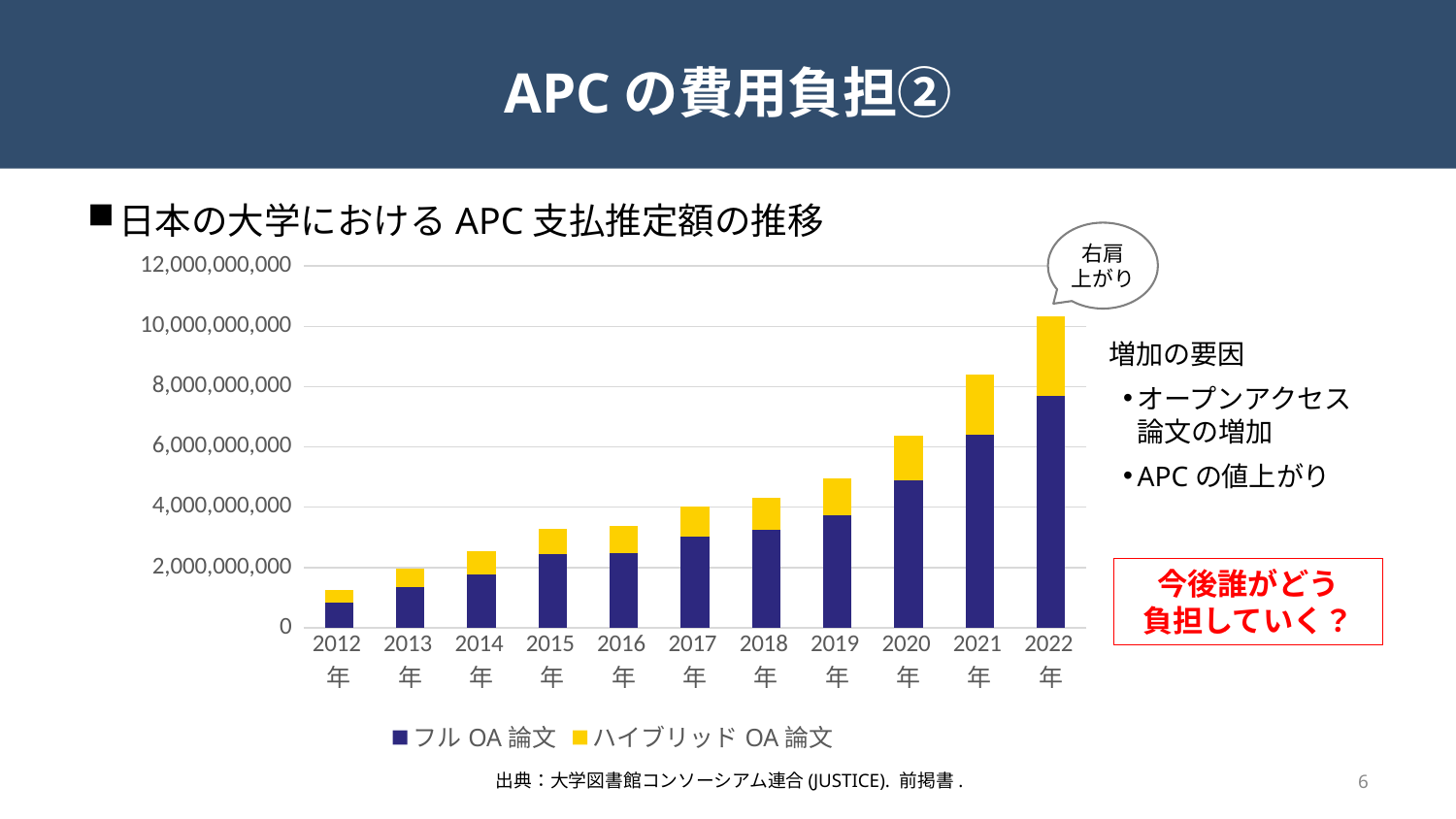
Which colour represents ハイブリッド OA 論文 in the chart? Yellow How many years are shown on the x axis of the chart? 11 What kind of chart is shown on the slide? Stacked bar chart Is the total value for 2022 greater or less than 10,000,000,000? greater How many series does the chart legend list? 2 Is the total value for 2012 greater or less than 2,000,000,000? less Which year has the lowest total estimated APC payment? 2012年 Is the total value for 2016 greater or less than 4,000,000,000? less Do the total values rise or fall from 2012 to 2022? Rise In 2022, which series is larger: フル OA 論文 or ハイブリッド OA 論文? フル OA 論文 Which year has the highest total estimated APC payment? 2022年